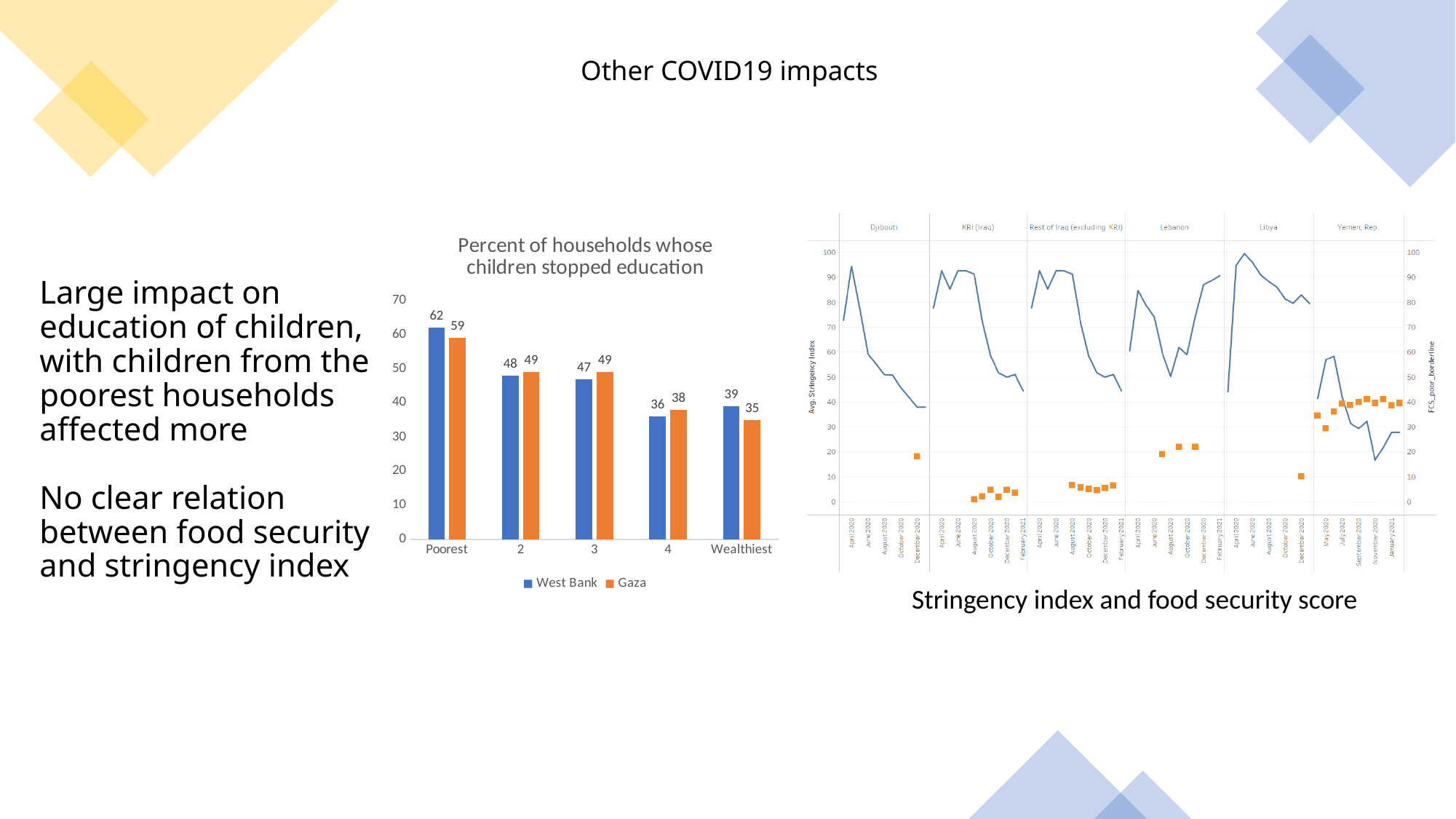
In the chart 'Percent of households whose children stopped education', what is the value for Gaza in the Wealthiest group? 35 In the chart 'Percent of households whose children stopped education', which is larger for the Wealthiest group, West Bank or Gaza? West Bank In the chart 'Stringency index and food security score', what is the label of the left vertical axis? Avg. Stringency Index In the chart 'Percent of households whose children stopped education', which group has the lowest Gaza value? Wealthiest In the chart 'Percent of households whose children stopped education', what is the difference between the West Bank and Gaza values for the Poorest group? 3 In the chart 'Percent of households whose children stopped education', what is the value for Gaza in group 4? 38 What kind of chart is 'Percent of households whose children stopped education'? Bar chart In the chart 'Percent of households whose children stopped education', how many wealth groups are shown on the x axis? 5 In the chart 'Percent of households whose children stopped education', which group has the highest West Bank value? Poorest In the chart 'Percent of households whose children stopped education', what is the value for West Bank in the Poorest group? 62 In the chart 'Percent of households whose children stopped education', how many series does the legend list? 2 In the chart 'Stringency index and food security score', how many country panels are shown? 6